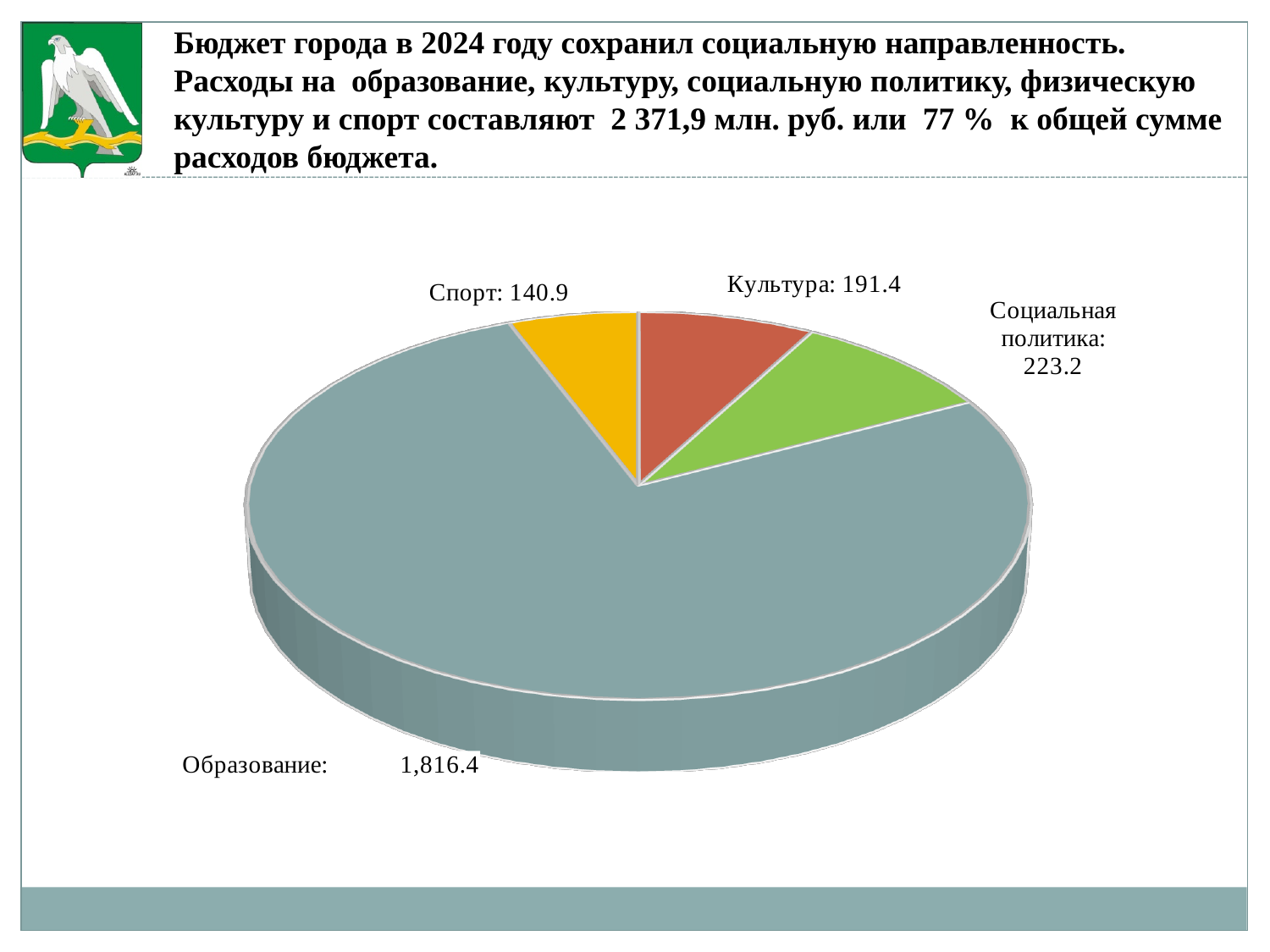
How many slices does the pie chart have? 4 What is the value for Спорт in the pie chart? 140.9 What is the value for Культура in the pie chart? 191.4 Which is larger, the value for Культура or the value for Социальная политика? Социальная политика What type of chart is shown on the slide? Pie chart Which category has the smallest slice in the pie chart? Спорт What is the value for Образование in the pie chart? 1,816.4 What colour is the Спорт slice in the pie chart? Yellow What is the total of all four slices in the pie chart? 2,371.9 Which category has the largest slice in the pie chart? Образование What is the value for Социальная политика in the pie chart? 223.2 What is the difference between the values for Социальная политика and Культура? 31.8